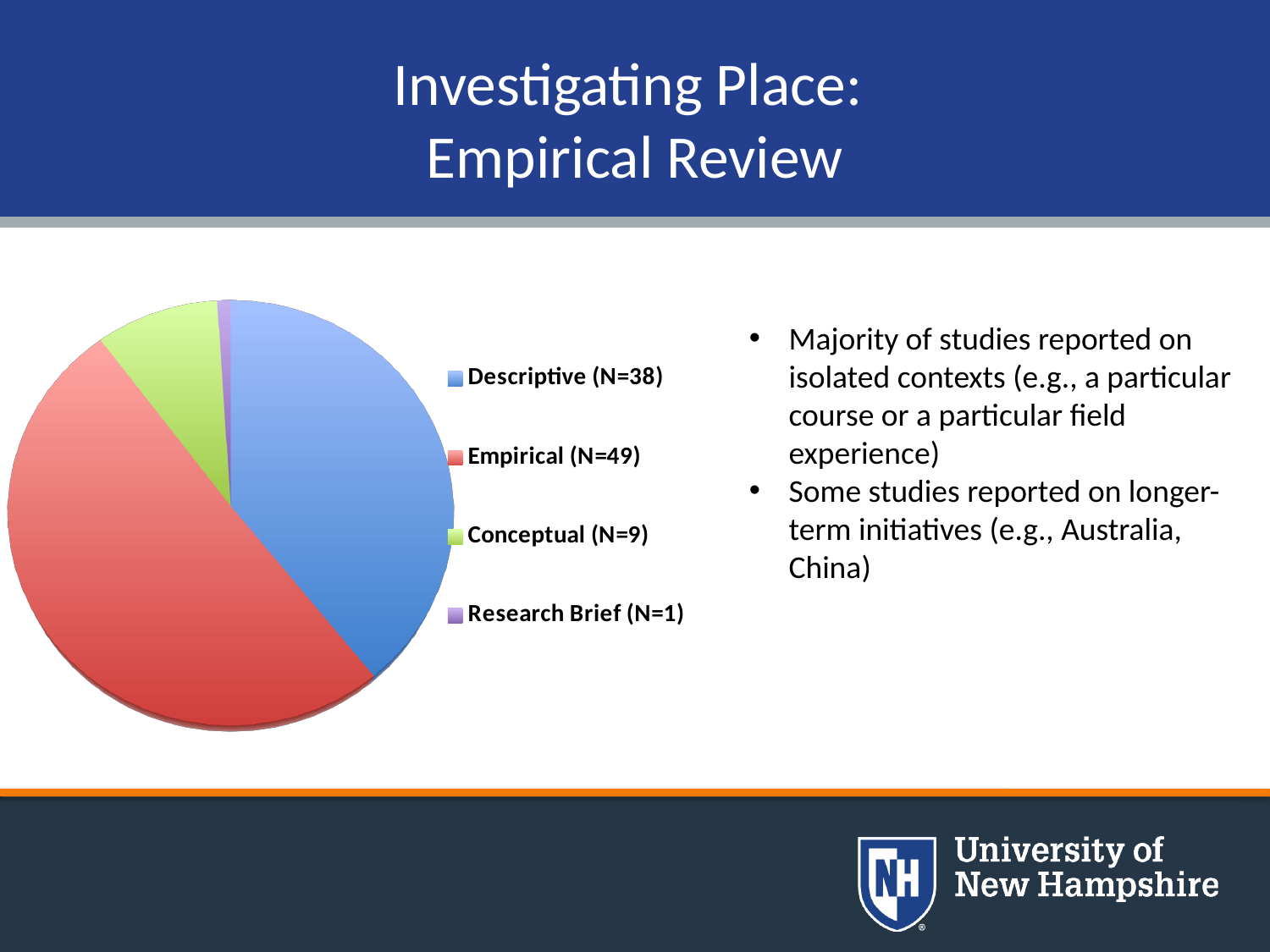
Which category has the largest slice in the pie chart? Empirical (N=49) Which category has the smallest slice in the pie chart? Research Brief (N=1) What colour is the Empirical slice in the pie chart? red What is the value (N) for the Research Brief category in the pie chart? 1 Which is larger in the pie chart, Conceptual or Research Brief? Conceptual What is the difference between the Empirical and Descriptive counts in the pie chart? 11 What is the value (N) for the Descriptive category in the pie chart? 38 What kind of chart is shown on the slide? pie chart How many categories does the pie chart show? 4 What is the total number of studies across all four categories in the pie chart? 97 What is the value (N) for the Conceptual category in the pie chart? 9 What is the value (N) for the Empirical category in the pie chart? 49